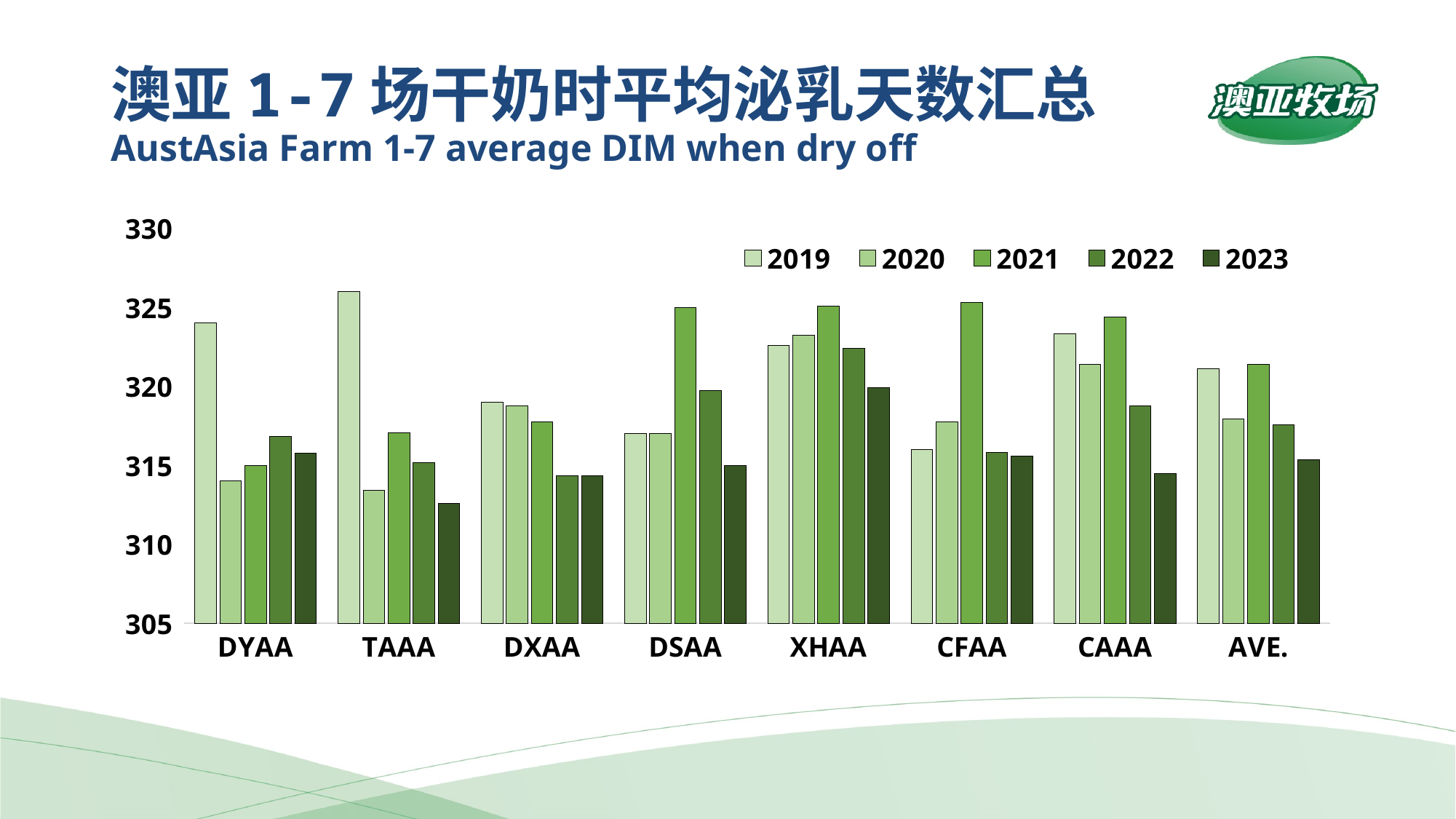
For DSAA, which year has the lowest value? 2023 What is the English title of the chart on the slide? AustAsia Farm 1-7 average DIM when dry off How many categories are shown along the x axis? 8 For DYAA, which is larger: the 2019 value or the 2020 value? 2019 For AVE., which is larger: the 2019 value or the 2023 value? 2019 Is the 2021 value for DSAA greater or less than 320? greater How many series does the legend list? 5 What kind of chart is shown on the slide? bar chart Is the 2023 value for TAAA greater or less than 315? less Is the 2019 value for TAAA greater or less than 320? greater For CFAA, which year has the highest value? 2021 For TAAA, which year has the highest value? 2019